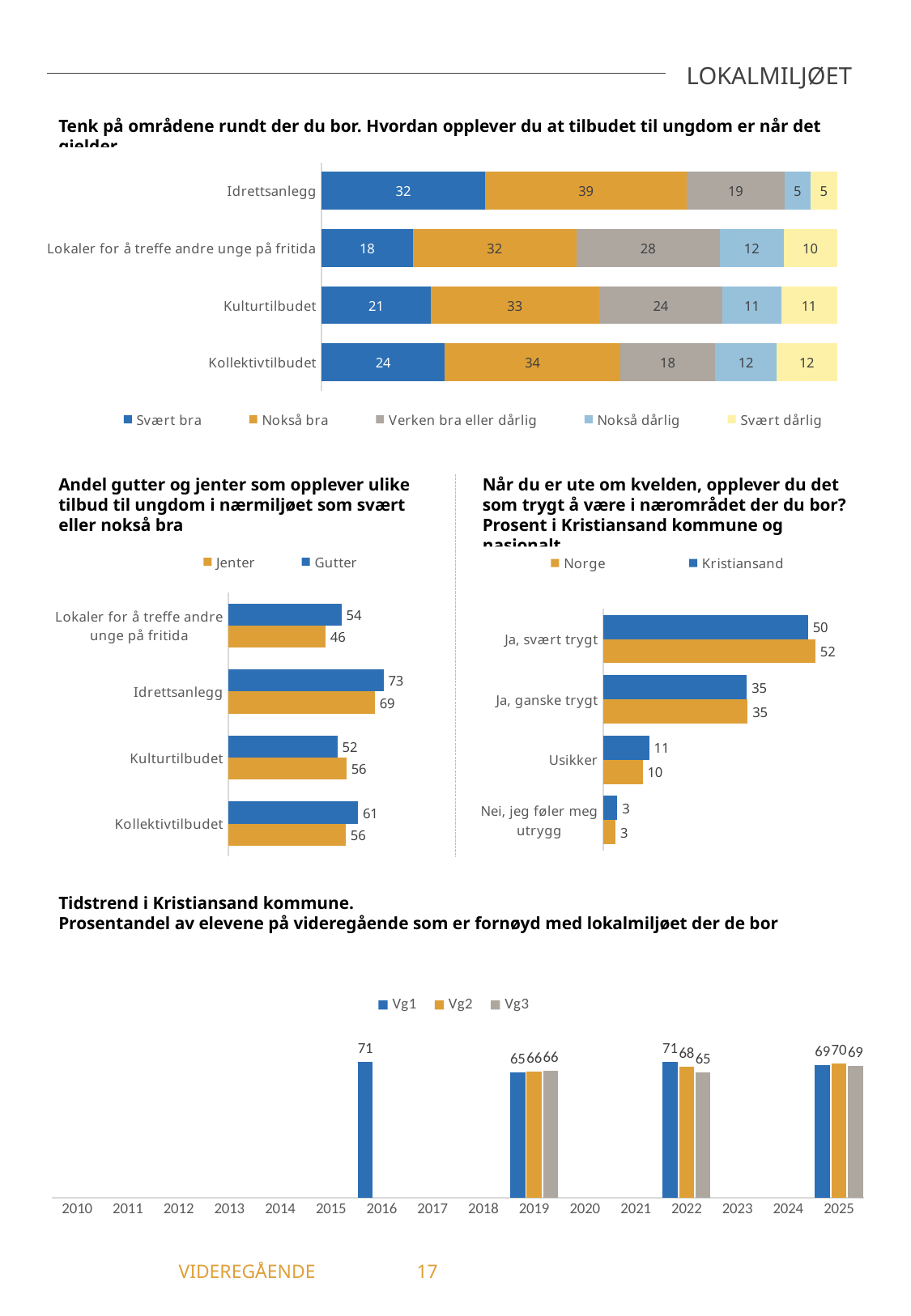
In the chart 'Når du er ute om kvelden, opplever du det som trygt å være i nærområdet der du bor?', what is the value for Norge for 'Ja, svært trygt'? 52 In the top stacked bar chart about the offer for young people, how many series does the legend list? 5 In the top stacked bar chart about the offer for young people, which category has the highest 'Nokså bra' value? Idrettsanlegg In the chart 'Andel gutter og jenter som opplever ulike tilbud til ungdom i nærmiljøet som svært eller nokså bra', which is larger for Kulturtilbudet, Jenter or Gutter? Jenter In the chart 'Tidstrend i Kristiansand kommune', how many series does the legend list? 3 In the top stacked bar chart about the offer for young people, what percentage answered 'Svært bra' for Idrettsanlegg? 32 In the chart 'Andel gutter og jenter som opplever ulike tilbud til ungdom i nærmiljøet som svært eller nokså bra', what is the difference between Gutter and Jenter for Lokaler for å treffe andre unge på fritida? 8 In the chart 'Tidstrend i Kristiansand kommune', what is the value for Vg2 in 2025? 70 In the chart 'Andel gutter og jenter som opplever ulike tilbud til ungdom i nærmiljøet som svært eller nokså bra', what is the value for Gutter for Idrettsanlegg? 73 In the top stacked bar chart about the offer for young people, what is the total of the Kollektivtilbudet bar? 100 What kind of chart is the 'Tidstrend i Kristiansand kommune' chart at the bottom of the slide? Bar chart In the chart 'Når du er ute om kvelden, opplever du det som trygt å være i nærområdet der du bor?', which category has the lowest values? Nei, jeg føler meg utrygg